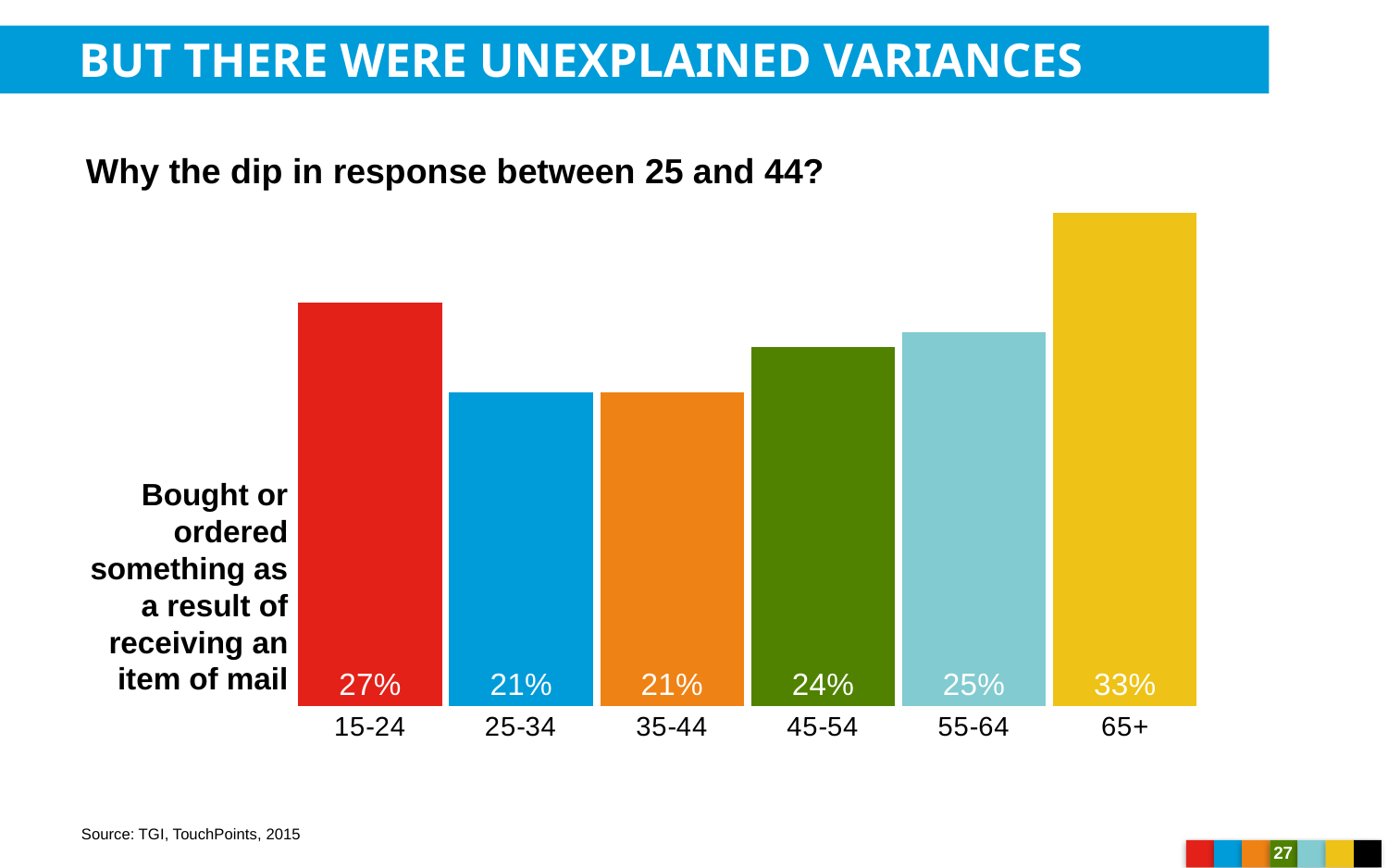
What percentage of the 15-24 age group bought or ordered something as a result of receiving an item of mail? 27% What is the difference between the values for the 65+ and 15-24 age groups? 6% Which is larger, the value for 15-24 or the value for 55-64? 15-24 What is the value shown for the 45-54 age group? 24% What kind of chart is shown on the slide? Bar chart Which age group has the highest percentage? 65+ What is the lowest percentage shown on the chart? 21% What is the source cited for the chart? TGI, TouchPoints, 2015 What is the value shown for the 65+ age group? 33% How many age groups are shown on the chart? 6 What is the difference between the values for the 55-64 and 25-34 age groups? 4% Do the values rise or fall from the 35-44 age group to the 65+ age group? Rise